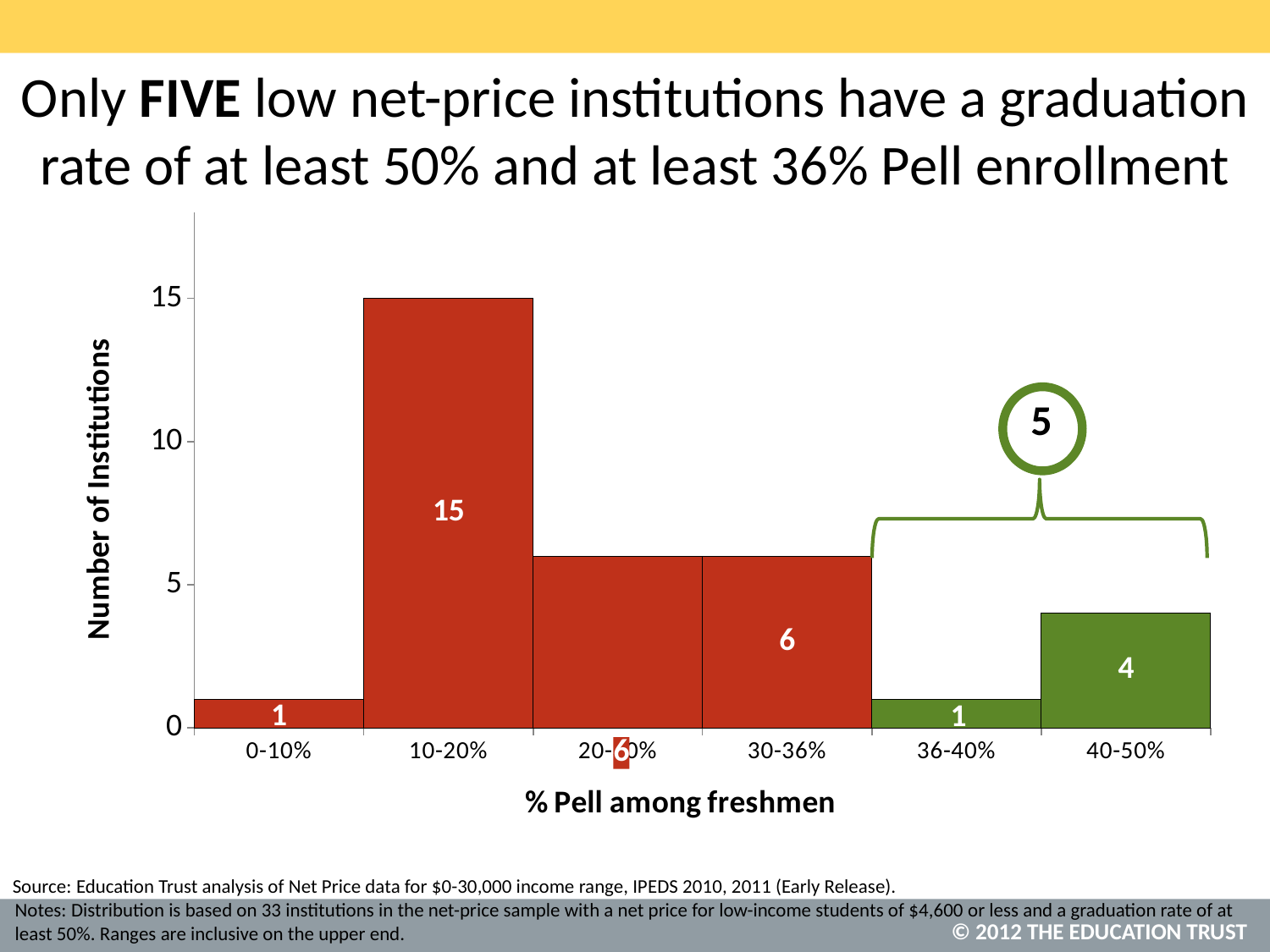
How many institutions are in the 36-40% Pell category? 1 What is the difference in the number of institutions between the 10-20% and 30-36% categories? 9 What type of chart is shown on the slide? bar chart How many institutions are in the 30-36% Pell category? 6 Which category has more institutions, 40-50% or 36-40%? 40-50% Which Pell category has the highest number of institutions? 10-20% How many institutions are in the 40-50% Pell category? 4 What is the label of the x axis? % Pell among freshmen What is the combined number of institutions in the 36-40% and 40-50% categories, as shown in the circle above the bracket? 5 Is the number of institutions in the 20-30% category greater or less than 10? less How many institutions are in the 10-20% Pell category? 15 How many Pell categories are shown on the x axis? 6